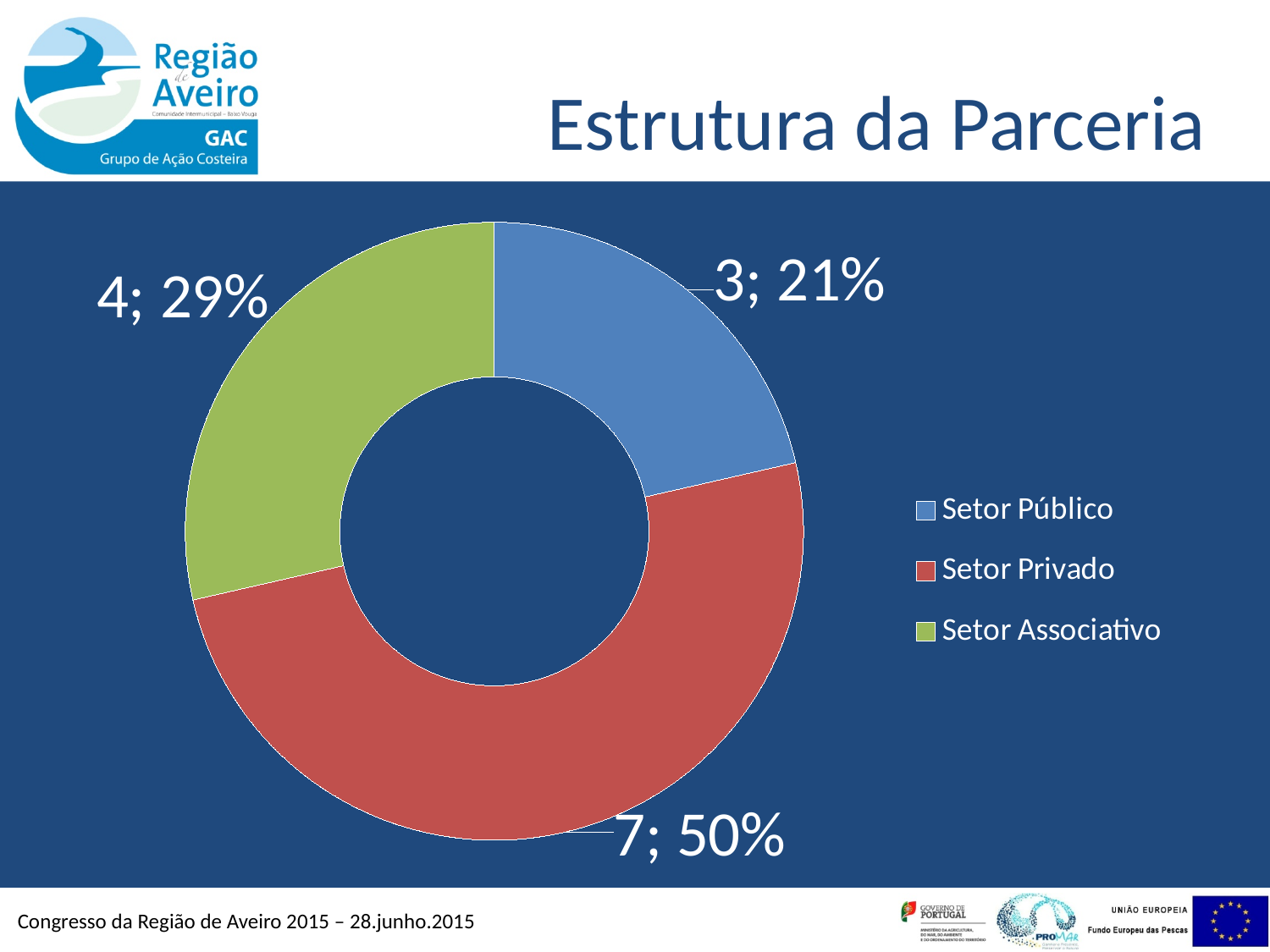
What share of the chart does Setor Associativo represent? 29% How many categories does the legend list? 3 What share of the chart does Setor Público represent? 21% Which is larger, the value for Setor Associativo or Setor Público? Setor Associativo What kind of chart is shown on the slide? Doughnut (pie) chart What is the difference between the values for Setor Privado and Setor Associativo? 3 What is the value for Setor Associativo? 4 What share of the chart does Setor Privado represent? 50% Which category has the smallest slice? Setor Público What is the value for Setor Público? 3 What is the value for Setor Privado? 7 Which category has the largest slice? Setor Privado